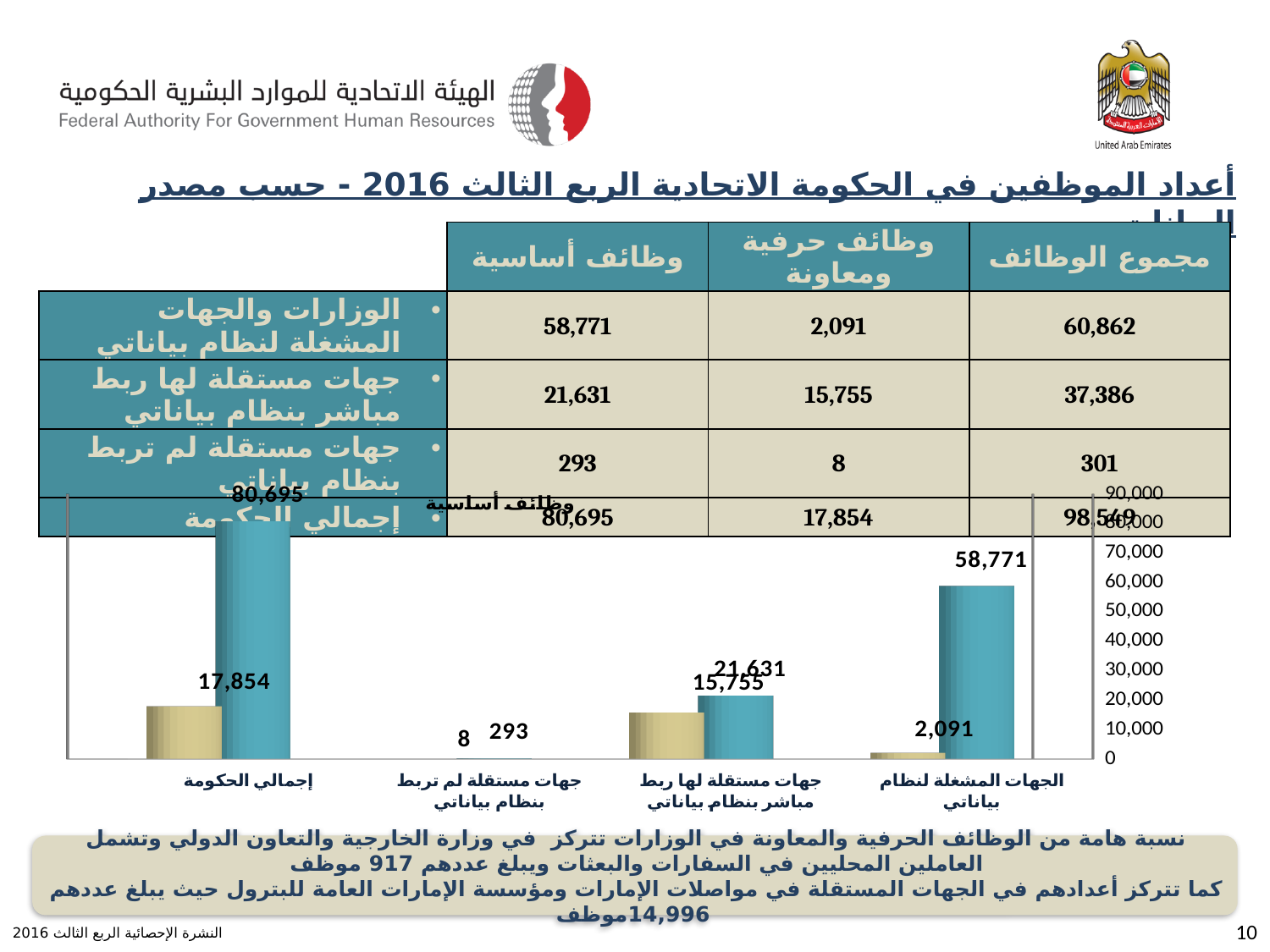
Which category has the highest وظائف أساسية bar in the chart? إجمالي الحكومة In the chart, what is the value of the tan bar for إجمالي الحكومة? 17,854 How many categories are shown on the x axis of the chart? 4 What is the maximum value shown on the chart's vertical axis? 90,000 In the chart, what is the value of the وظائف أساسية bar for جهات مستقلة لها ربط مباشر بنظام بياناتي? 21,631 Is the وظائف أساسية value for إجمالي الحكومة greater or less than 70,000? greater What type of chart is shown on the slide? bar chart In the chart, which is larger for الجهات المشغلة لنظام بياناتي: the وظائف أساسية bar or the tan bar? وظائف أساسية In the chart, what is the value of the smaller (tan) bar for الجهات المشغلة لنظام بياناتي? 2,091 Which category has the lowest وظائف أساسية bar in the chart? جهات مستقلة لم تربط بنظام بياناتي In the chart, what is the difference between the two bars for جهات مستقلة لها ربط مباشر بنظام بياناتي (21,631 and 15,755)? 5,876 In the chart, what is the value of the وظائف أساسية bar for الجهات المشغلة لنظام بياناتي? 58,771